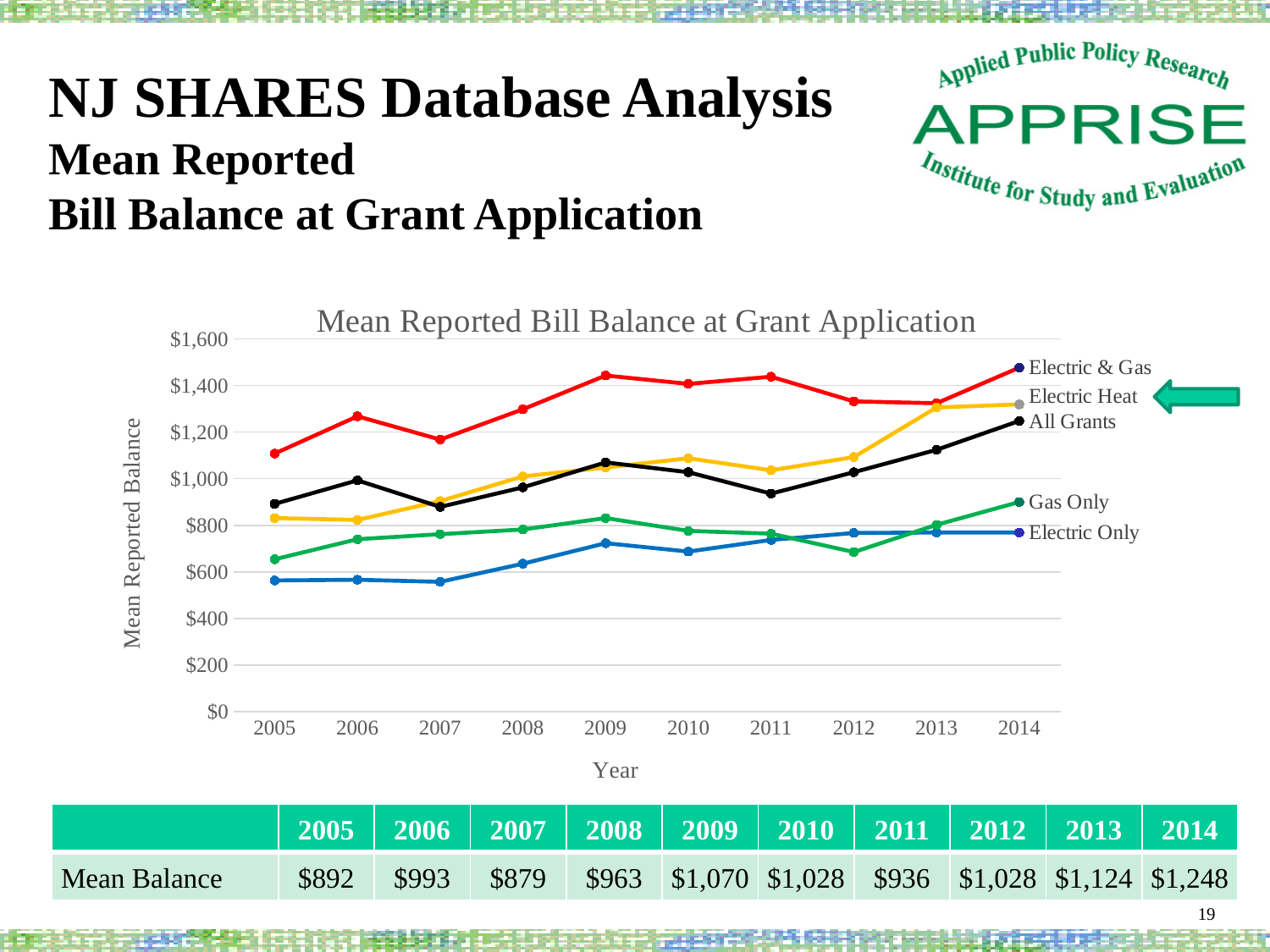
Which series has the lowest value in 2005? Electric Only Is the value for Gas Only in 2012 greater or less than $800? less How many years are shown along the x axis of the chart? 10 What kind of chart is shown on the slide? line chart Which series has the highest value in 2014? Electric & Gas What is the title of the chart? Mean Reported Bill Balance at Grant Application Is the value for Electric Only in 2005 greater or less than $600? less According to the table below the chart, what is the Mean Balance for 2014? $1,248 Using the table below the chart, how much higher is the Mean Balance in 2014 than in 2005? $356 According to the table below the chart, what is the Mean Balance for 2009? $1,070 Is the value for Electric Heat in 2013 greater or less than $1,200? greater How many series are plotted in the chart? 5